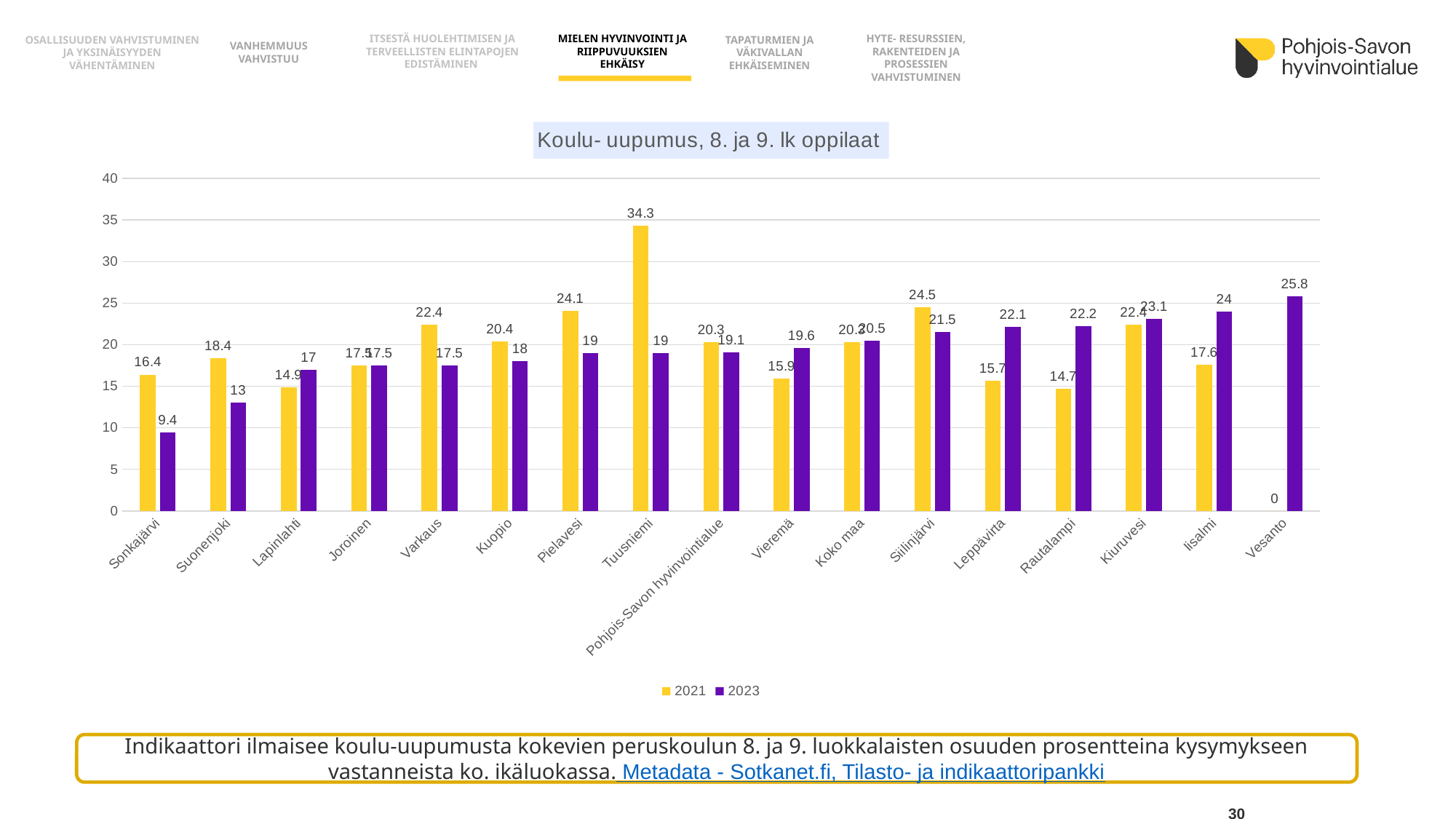
What is the 2021 value for Tuusniemi? 34.3 How many series does the legend list? 2 What is the 2021 value for Pohjois-Savon hyvinvointialue? 20.3 Which colour represents the 2023 series in the legend? purple Which category has the lowest 2023 value? Sonkajärvi Which is larger for Rautalampi, the 2021 value or the 2023 value? 2023 What is the 2023 value for Vesanto? 25.8 How many categories are shown on the x axis? 17 What type of chart is shown on the slide? bar chart What is the difference between the 2021 and 2023 values for Tuusniemi? 15.3 What is the 2023 value for Sonkajärvi? 9.4 Which category has the highest 2021 value? Tuusniemi